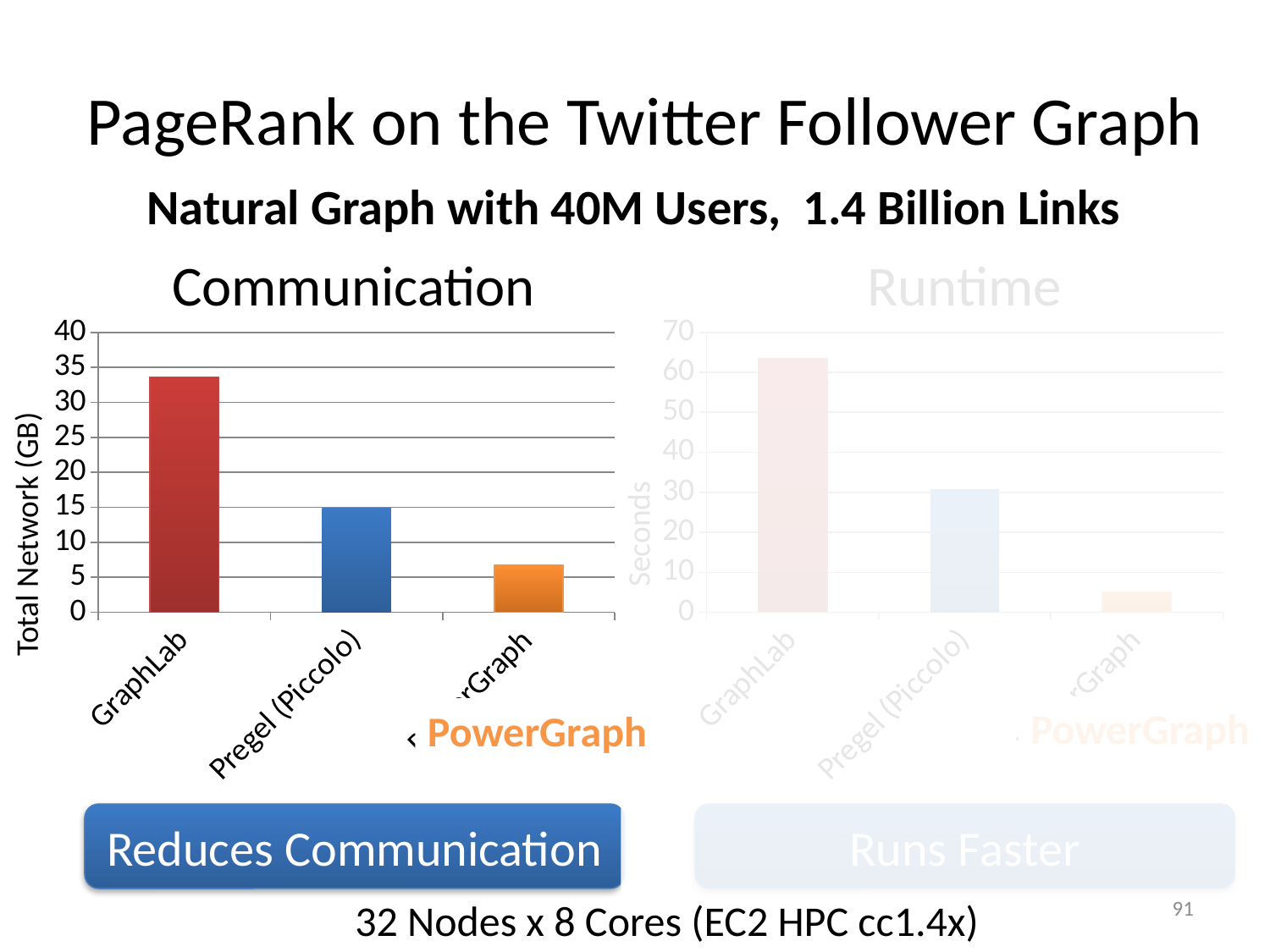
In the Communication chart, is the value for Pregel (Piccolo) greater or less than 10? greater In the Communication chart, is the value for PowerGraph greater or less than 10? less In the Communication chart, do the values rise or fall from left to right across the categories? fall In the Runtime chart, is the value for GraphLab greater or less than 60? greater What kind of chart is the Communication chart? bar chart In the Communication chart, which system has the lowest total network usage? PowerGraph In the Communication chart, which is larger, the value for Pregel (Piccolo) or the value for PowerGraph? Pregel (Piccolo) In the Communication chart, which system has the highest total network usage? GraphLab How many categories are shown in the Communication chart? 3 In the Runtime chart, which system has the highest runtime? GraphLab What is the y-axis title of the Communication chart? Total Network (GB)